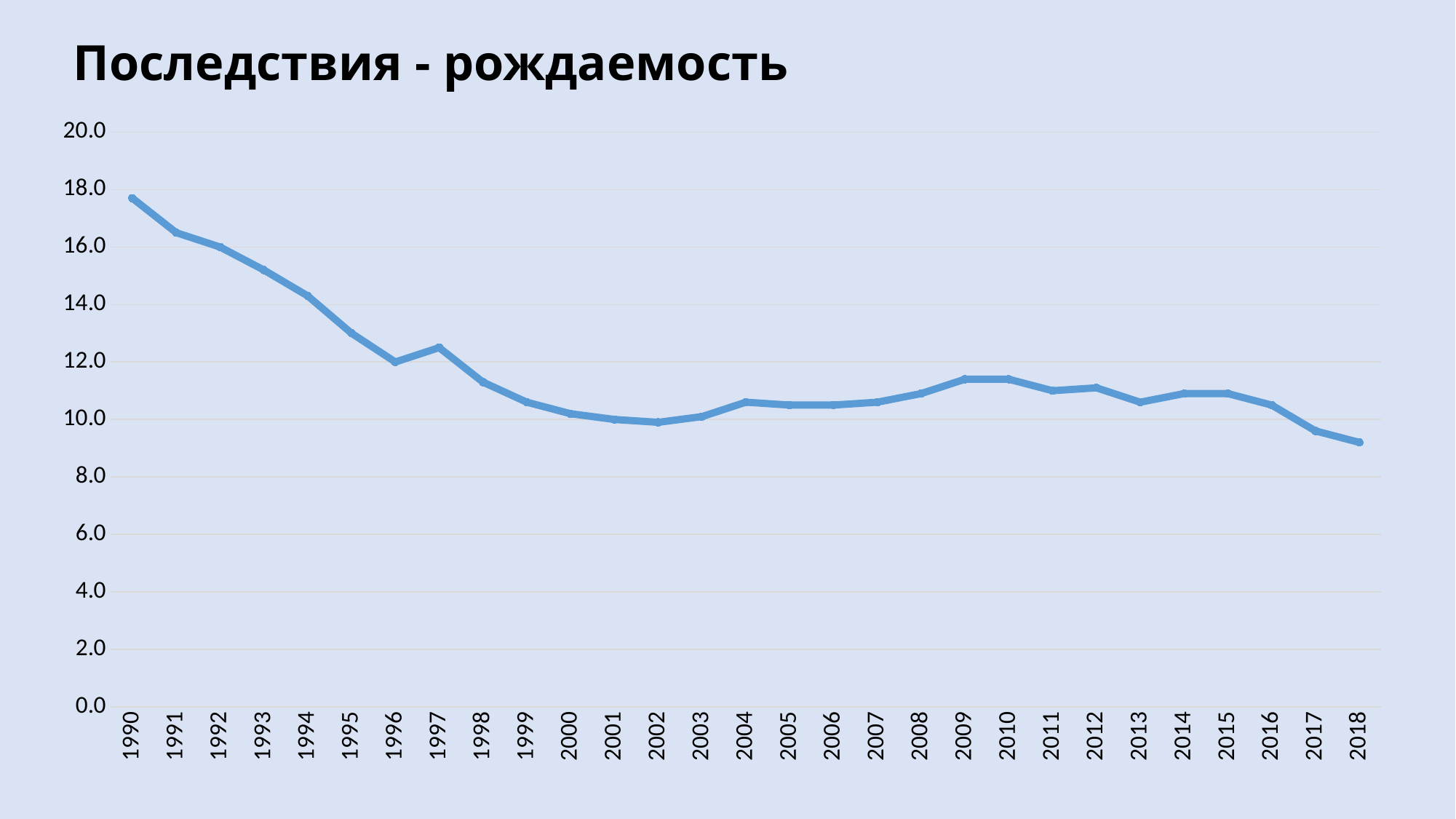
Which is larger, the value for 1997 or the value for 1996? 1997 Is the value for 2018 greater or less than 10.0? less What is the title of the chart? Последствия - рождаемость Is the value for 1990 greater or less than 16.0? greater Is the value for 2009 greater or less than 10.0? greater How many years are plotted along the x axis? 29 What kind of chart is shown on the slide? line chart Which is larger, the value for 1990 or the value for 2018? 1990 Which year has the highest value? 1990 Which year has the lowest value? 2018 Do the values generally rise or fall from 1990 to 1996? fall